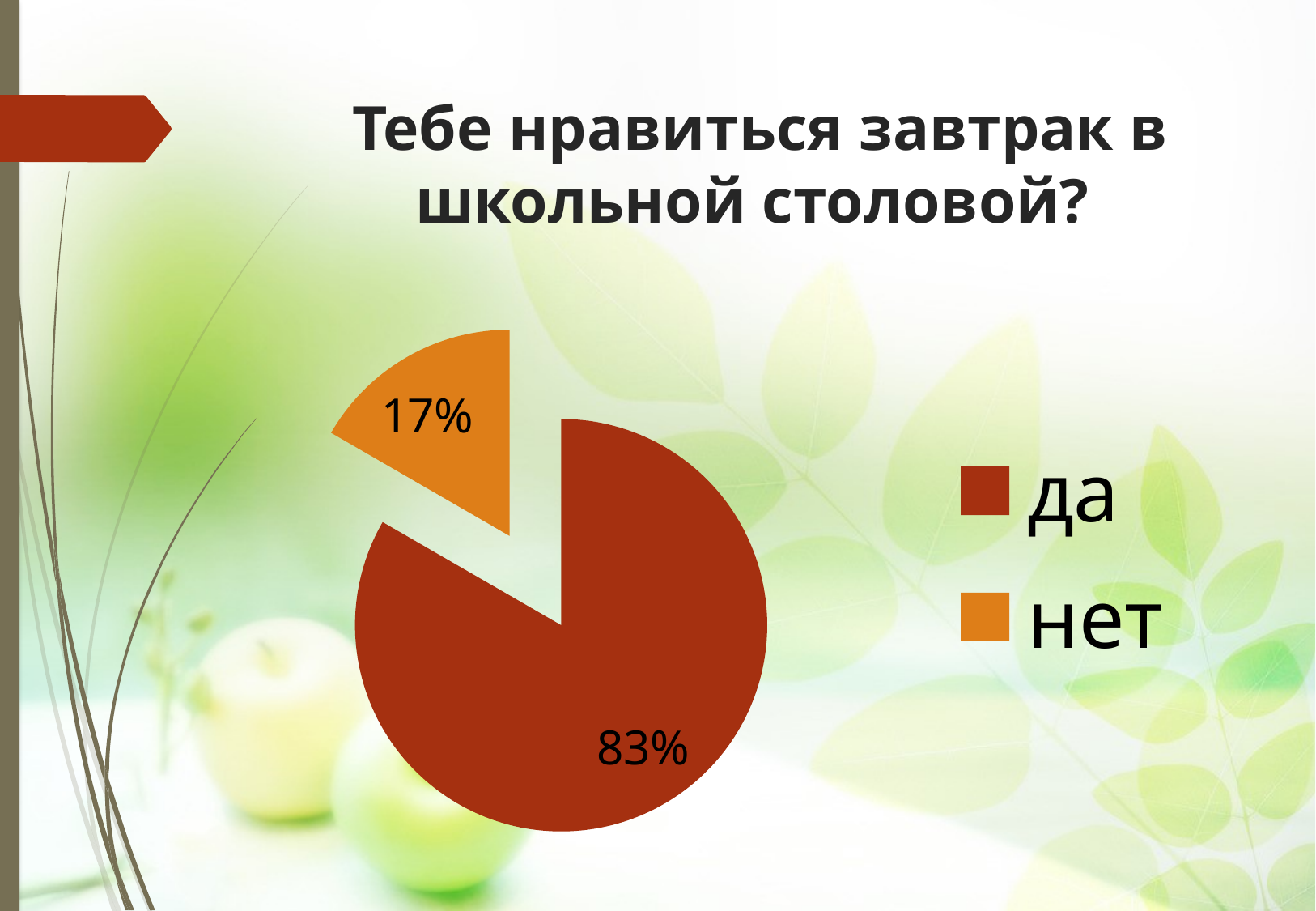
What is the title of the chart on the slide? Тебе нравиться завтрак в школьной столовой? What is the difference in percentage points between "да" and "нет"? 66 What kind of chart is shown on the slide? pie chart How many entries does the legend list? 2 Which answer has the smallest share of the pie? нет What percentage of respondents answered "да"? 83% Which answer has the largest share of the pie? да Which colour represents "нет" in the legend? orange What percentage of respondents answered "нет"? 17% Which is larger, the share for "да" or the share for "нет"? да How many slices does the pie chart have? 2 What share of the pie does the "нет" slice represent? 17%